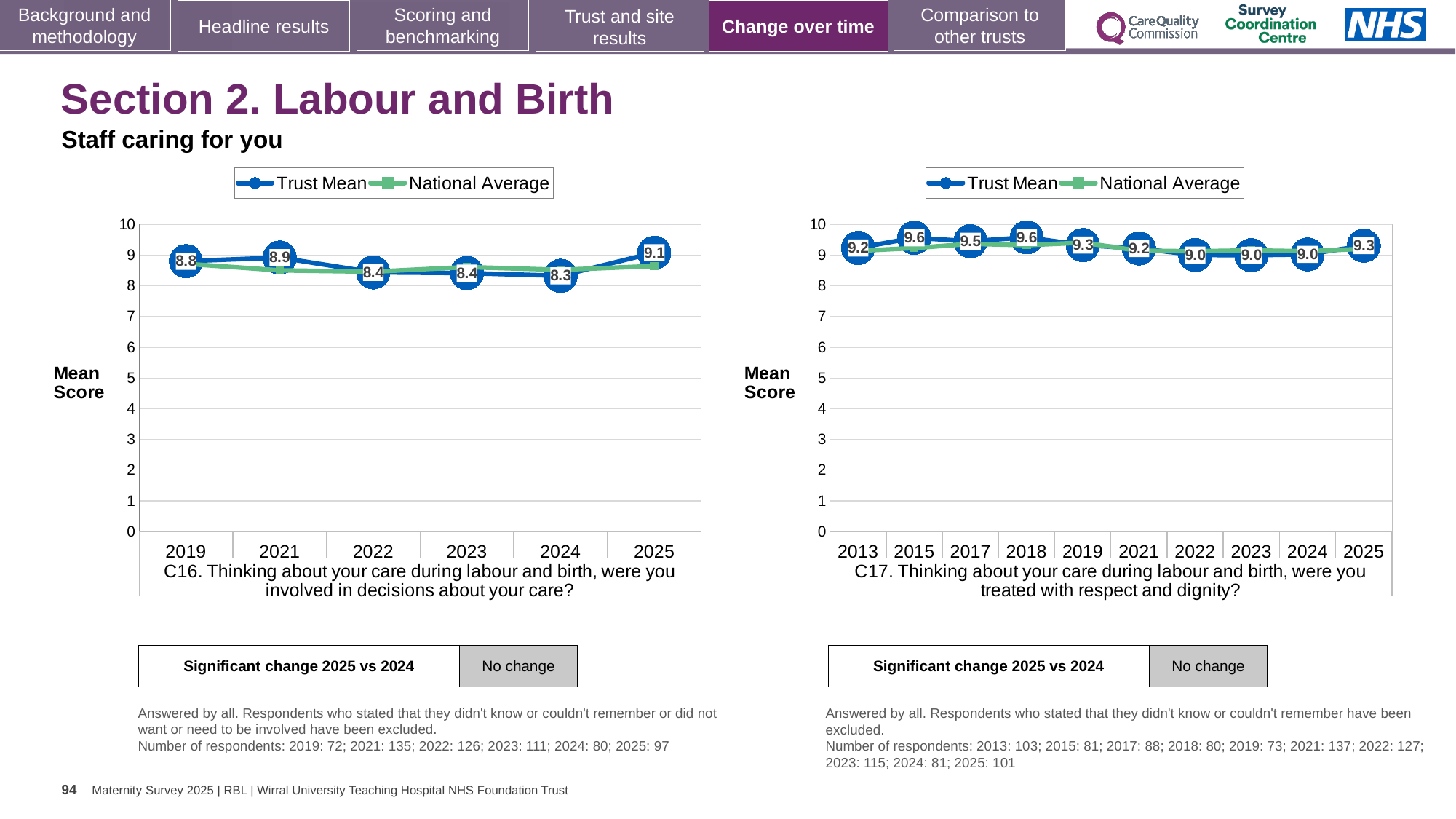
In the C17 chart on the right, is the Trust Mean score higher in 2015 or in 2019? 2015 In the C16 chart on the left, which year has the highest Trust Mean score? 2025 In the C17 chart on the right, what is the difference between the Trust Mean scores for 2018 and 2022? 0.6 In the C16 chart on the left, what is the difference between the Trust Mean scores for 2025 and 2024? 0.8 In the C16 chart on the left, what is the Trust Mean score for 2025? 9.1 How many years are plotted on the x axis of the C17 chart on the right? 10 In the C16 chart on the left, which year has the lowest Trust Mean score? 2024 In the C16 chart on the left, what is the Trust Mean score for 2022? 8.4 In the C17 chart on the right, what is the Trust Mean score for 2023? 9.0 How many series does the legend of the C16 chart on the left list? 2 What type of chart is the C16 chart on the left? Line chart In the C17 chart on the right, what is the Trust Mean score for 2013? 9.2